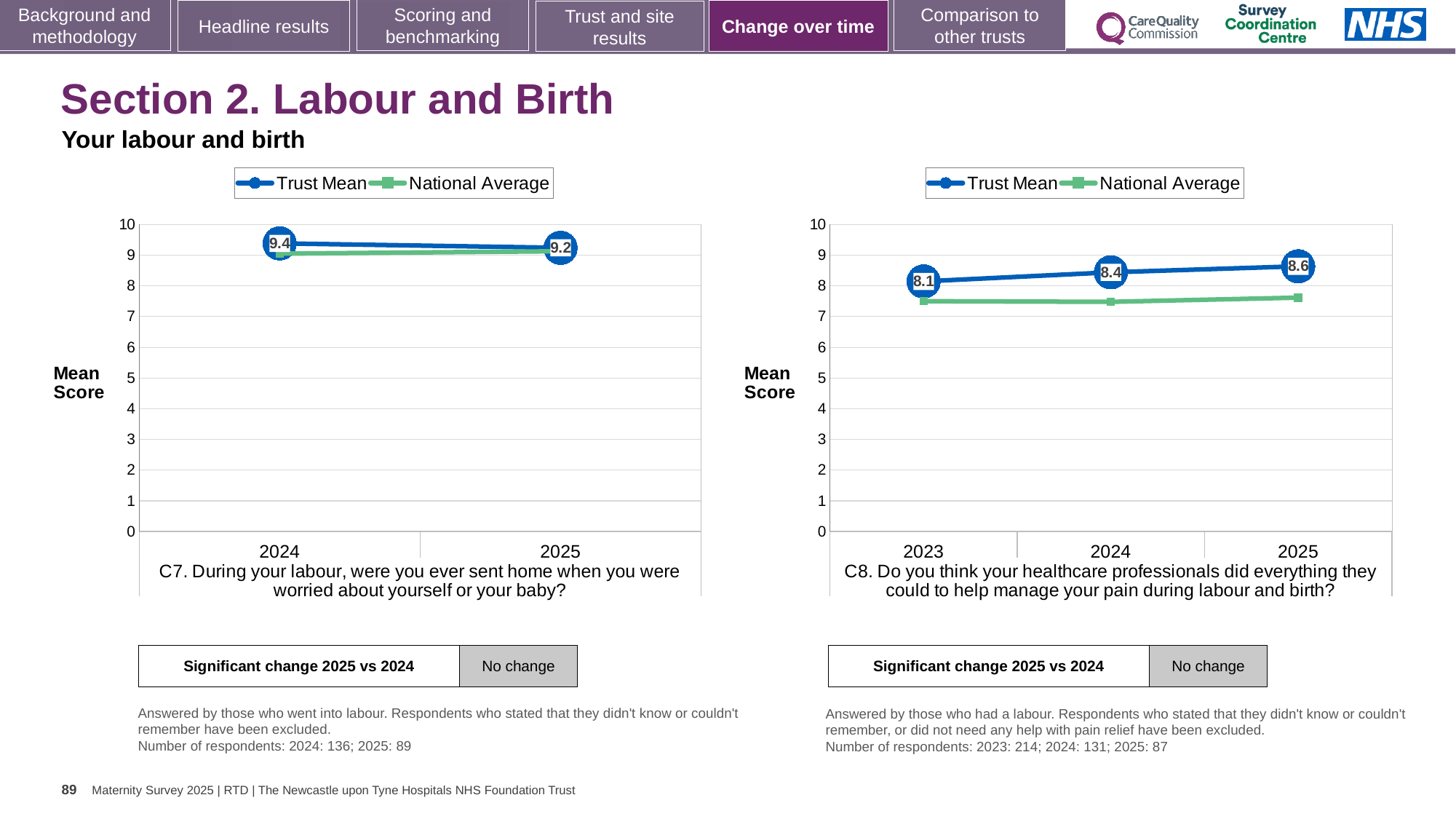
In the C8 chart (right), is the National Average for 2023 greater or less than 8? less What type of chart is the C7 chart (left)? line chart In the C8 chart (right), what is the Trust Mean for 2025? 8.6 In the C8 chart (right), which year has the highest Trust Mean? 2025 In the C8 chart (right), does the Trust Mean rise or fall across the years shown? rise In the C8 chart (right), what is the Trust Mean for 2023? 8.1 In the C7 chart (left), by how much did the Trust Mean change from 2024 to 2025? 0.2 In the C7 chart (left), does the Trust Mean rise or fall from 2024 to 2025? fall How many years are plotted on the x axis of the C8 chart (right)? 3 In the C7 chart (left), what is the Trust Mean for 2025? 9.2 In the C8 chart (right), what is the difference between the Trust Mean in 2025 and in 2023? 0.5 In the C7 chart (left), what is the Trust Mean for 2024? 9.4